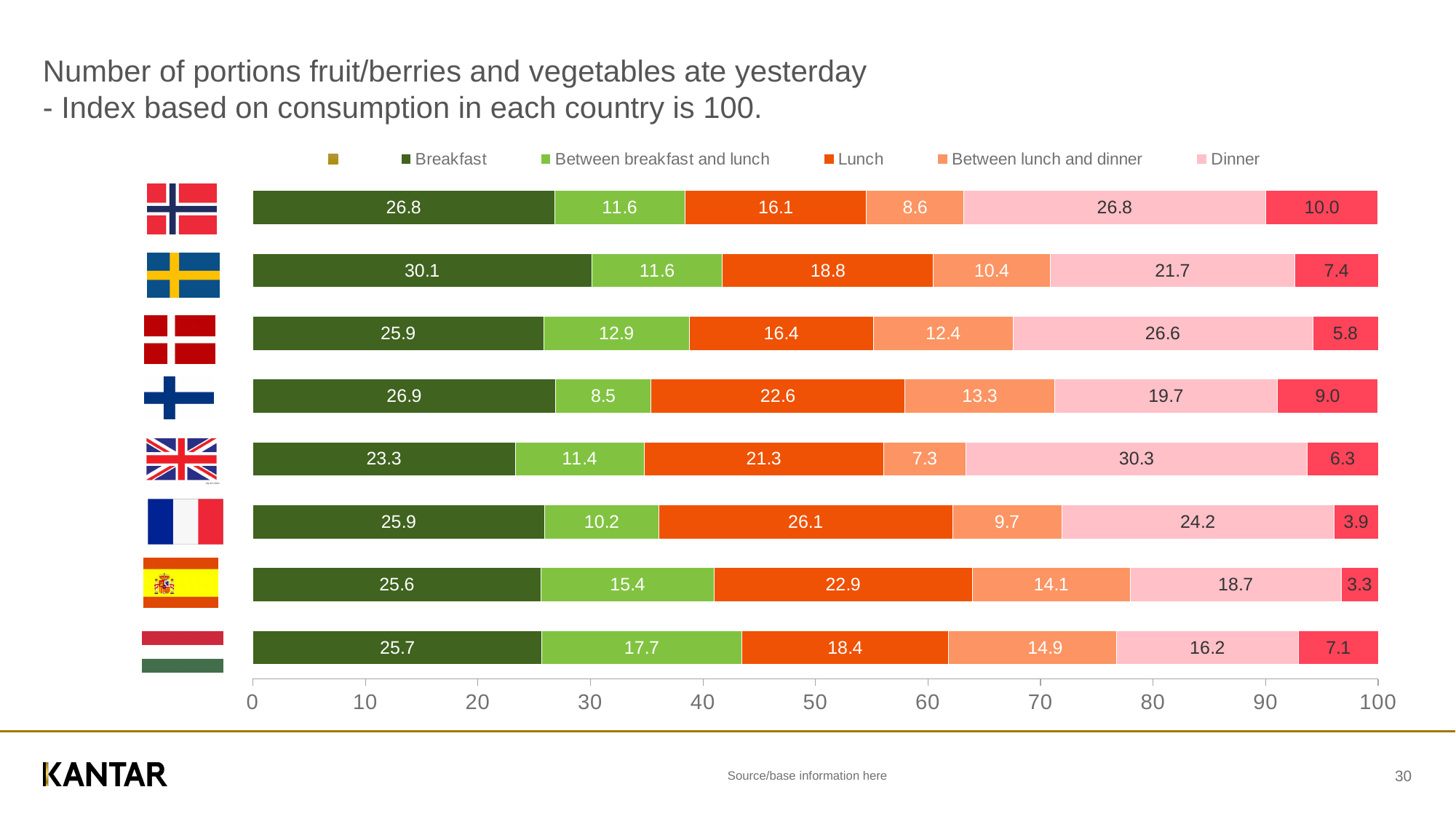
What is the Breakfast value for the top bar (Norwegian flag)? 26.8 What kind of chart is shown on the slide? stacked bar chart For the fifth bar from the top (UK flag), which is larger: the Dinner value or the Breakfast value? Dinner Which bar has the highest Breakfast value? the second bar from the top (Swedish flag), 30.1 What is the Lunch value for the second bar from the top (Swedish flag)? 18.8 For the second bar from the top (Swedish flag), what is the difference between the Dinner value and the 'Between lunch and dinner' value? 11.3 For the top bar (Norwegian flag), what is the difference between the Breakfast value and the Lunch value? 10.7 Which bar has the lowest Dinner value? the bottom bar (Hungarian flag), 16.2 What is the maximum value shown on the horizontal axis? 100 What is the 'Between breakfast and lunch' value for the bottom bar (Hungarian flag)? 17.7 Which bar has the highest Lunch value? the sixth bar from the top (French flag), 26.1 How many bars (countries) are plotted in the chart? 8